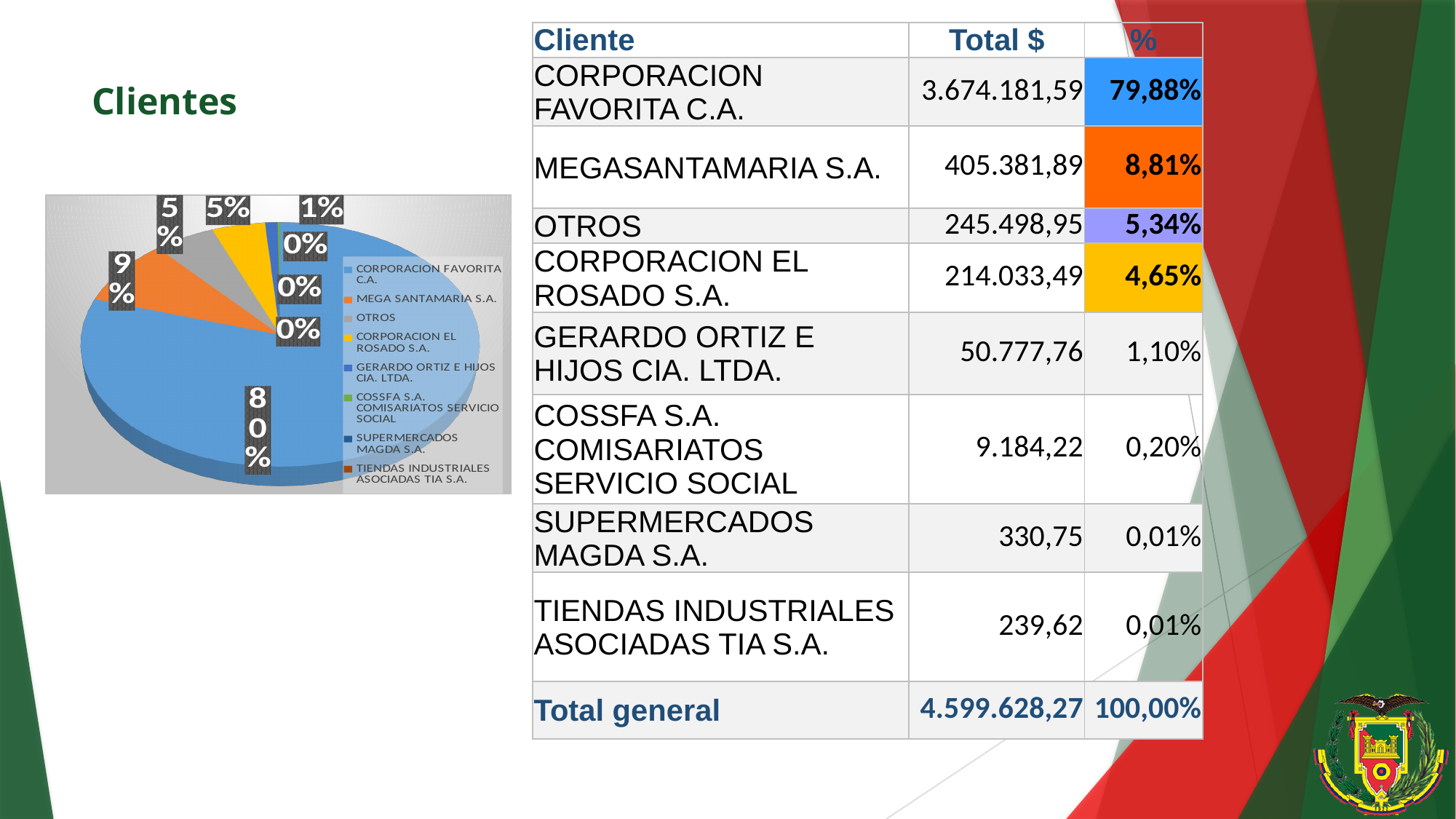
How many entries does the legend of the pie chart list? 8 What percentage label does the pie chart show for GERARDO ORTIZ E HIJOS CIA. LTDA.? 1% What percentage label does the pie chart show for MEGA SANTAMARIA S.A.? 9% In the pie chart, which slice is larger: MEGA SANTAMARIA S.A. or OTROS? MEGA SANTAMARIA S.A. What percentage label does the pie chart show for CORPORACION FAVORITA C.A.? 80% How many slices in the pie chart are labelled 0%? 3 What is the heading shown on the slide above the pie chart? Clientes What kind of chart is shown on the slide? Pie chart By how many percentage points does the CORPORACION FAVORITA C.A. label exceed the MEGA SANTAMARIA S.A. label in the pie chart? 71 Which client has the largest slice in the pie chart? CORPORACION FAVORITA C.A. What colour is the largest slice of the pie chart? Blue What percentage label does the pie chart show for CORPORACION EL ROSADO S.A.? 5%